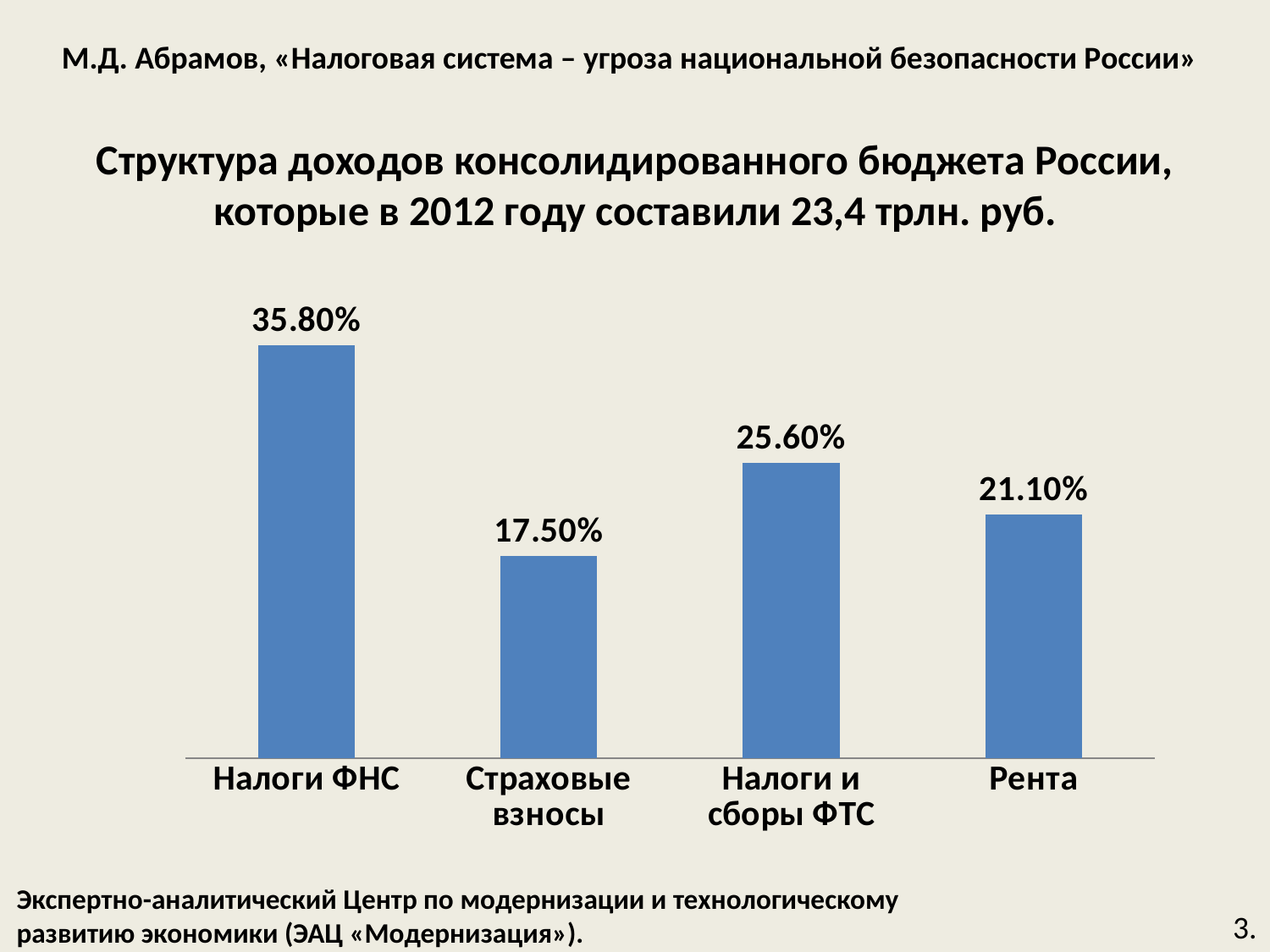
What is the title of the chart? Структура доходов консолидированного бюджета России, которые в 2012 году составили 23,4 трлн. руб. Which is larger, the value for Налоги и сборы ФТС or the value for Рента? Налоги и сборы ФТС What is the value for Страховые взносы? 17.50% What is the value for Налоги ФНС? 35.80% What is the value for Рента? 21.10% What is the difference between the values for Налоги ФНС and Страховые взносы? 18.30% What is the difference between the values for Налоги и сборы ФТС and Рента? 4.50% Which category has the lowest value? Страховые взносы What is the value for Налоги и сборы ФТС? 25.60% How many categories are shown in the chart? 4 Which category has the highest value? Налоги ФНС What kind of chart is shown on the slide? Bar chart